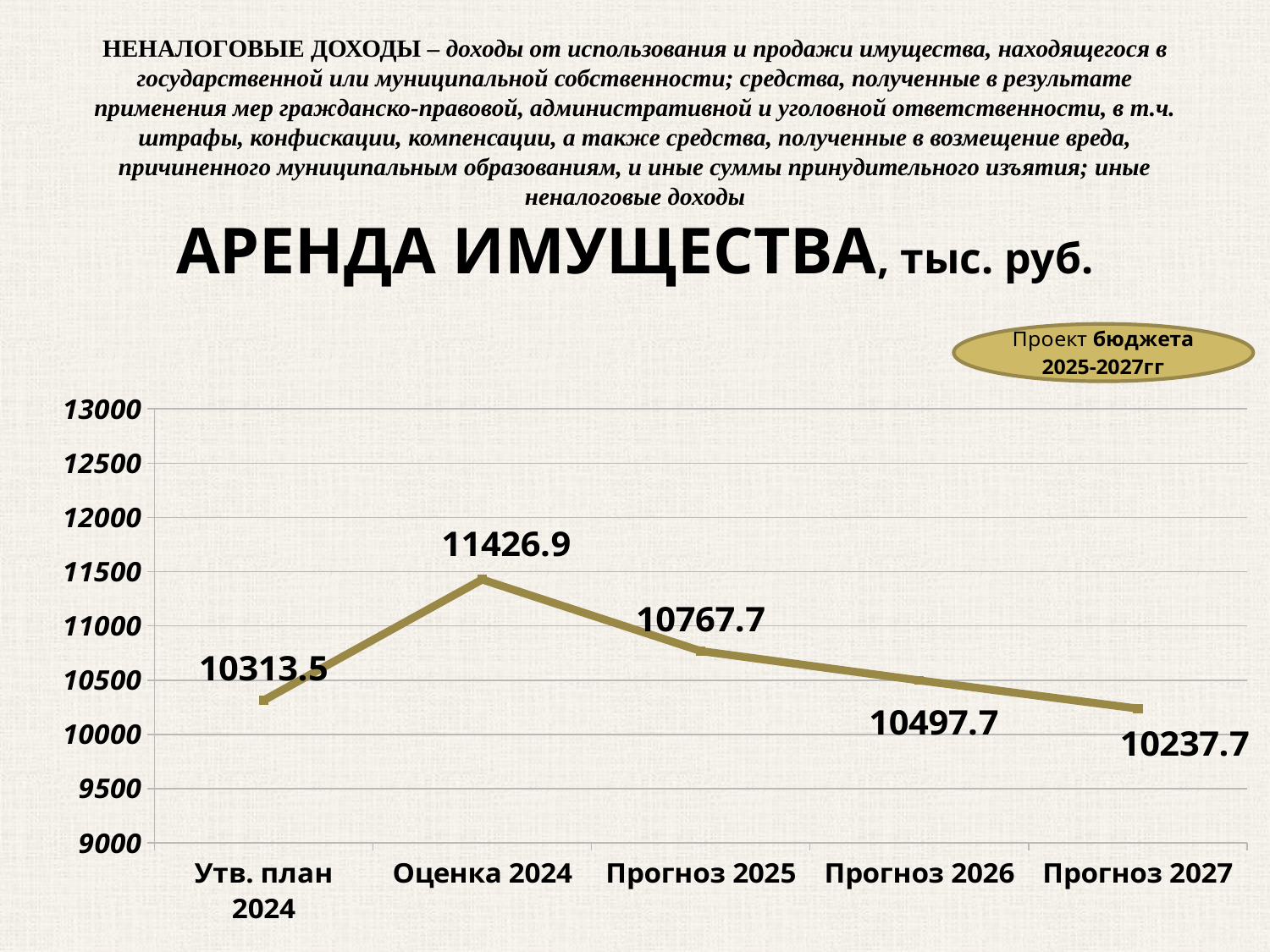
What is the value for Прогноз 2027? 10237.7 Which category has the highest value? Оценка 2024 What is the value for Утв. план 2024? 10313.5 What kind of chart is shown on the slide? line chart What is the difference between the values for Оценка 2024 and Утв. план 2024? 1113.4 How many data points are plotted on the chart? 5 Is the value for Оценка 2024 greater or less than 11000? greater Which is larger, the value for Прогноз 2025 or the value for Прогноз 2026? Прогноз 2025 What is the value for Оценка 2024? 11426.9 What is the difference between the values for Прогноз 2025 and Прогноз 2026? 270.0 Do the values rise or fall from Оценка 2024 to Прогноз 2027? fall Which category has the lowest value? Прогноз 2027